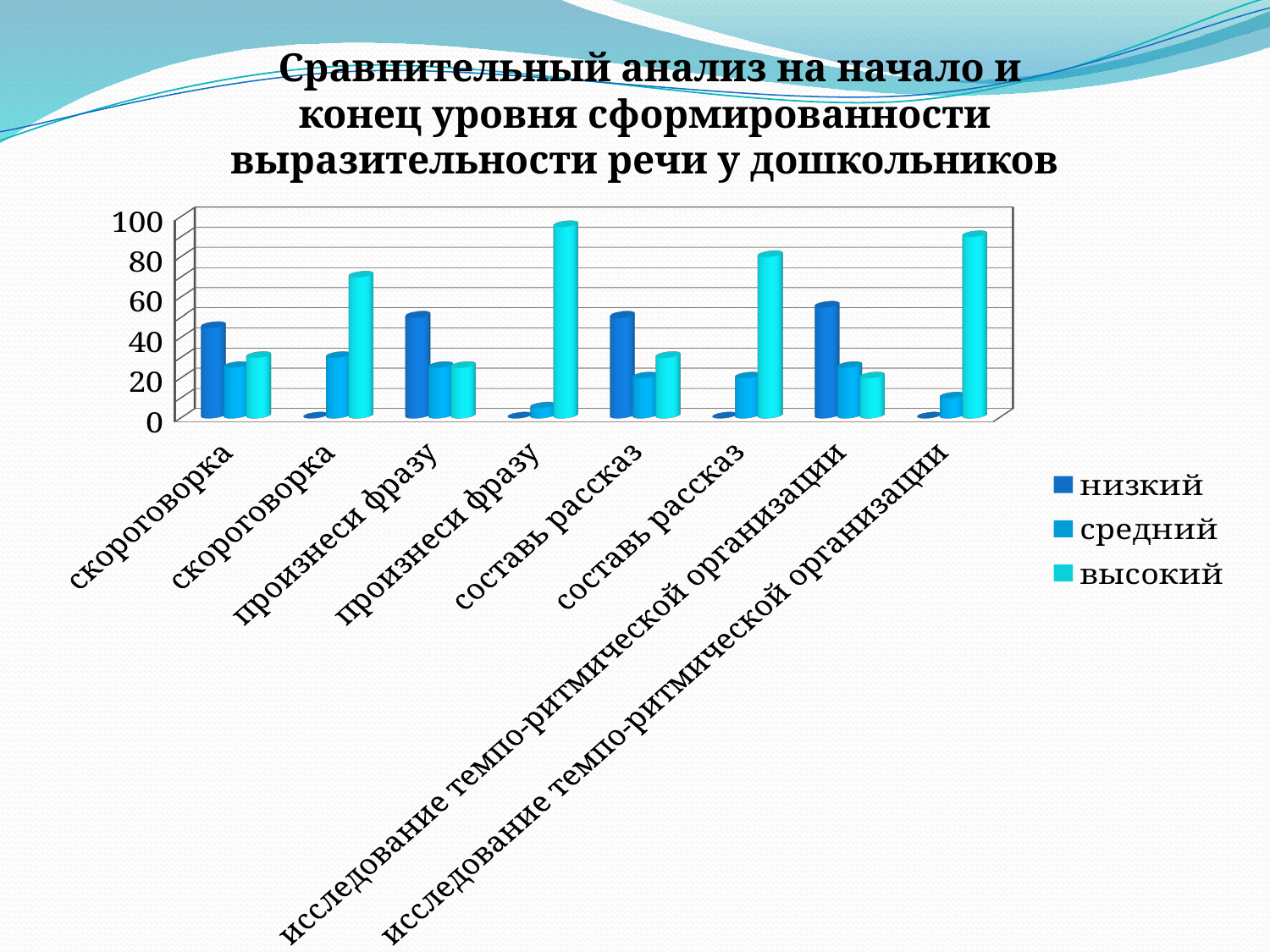
How many series does the legend list? 3 Is the value of средний for the second "произнеси фразу" category greater or less than 20? less Is the value of низкий for the first "скороговорка" category greater or less than 40? greater Is the value of высокий for the second "составь рассказ" category greater or less than 60? greater Which series has the highest value in the first "исследование темпо-ритмической организации" category? низкий In the first "скороговорка" category, which is larger: низкий or средний? низкий What are the three series named in the legend? низкий, средний, высокий What kind of chart is shown on the slide? bar chart How many categories are shown along the x axis? 8 In the second "скороговорка" category, which is larger: средний or высокий? высокий